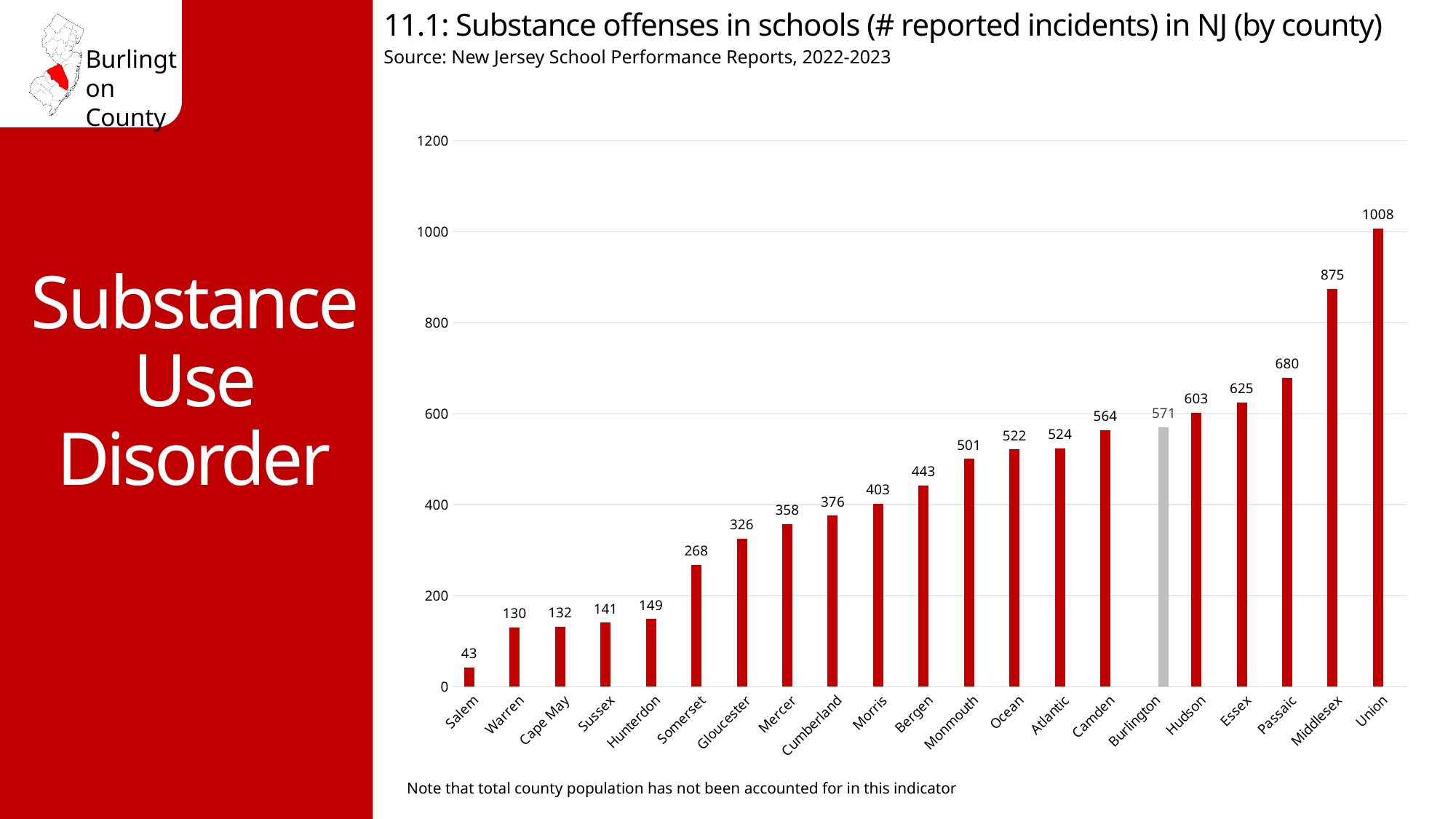
Which has a higher value, Hudson or Essex? Essex Which county's bar is coloured grey instead of red? Burlington Is the value for Passaic greater or less than 600? greater Which county has the lowest number of reported incidents? Salem What is the difference between the values for Union and Middlesex? 133 Which county has the highest number of reported incidents? Union What kind of chart is shown on the slide? Bar chart What is the difference between the values for Burlington and Camden? 7 What is the value shown for Gloucester County? 326 What is the number of reported substance offense incidents in schools for Burlington County? 571 How many counties are shown on the chart? 21 What is the value shown for Union County? 1008